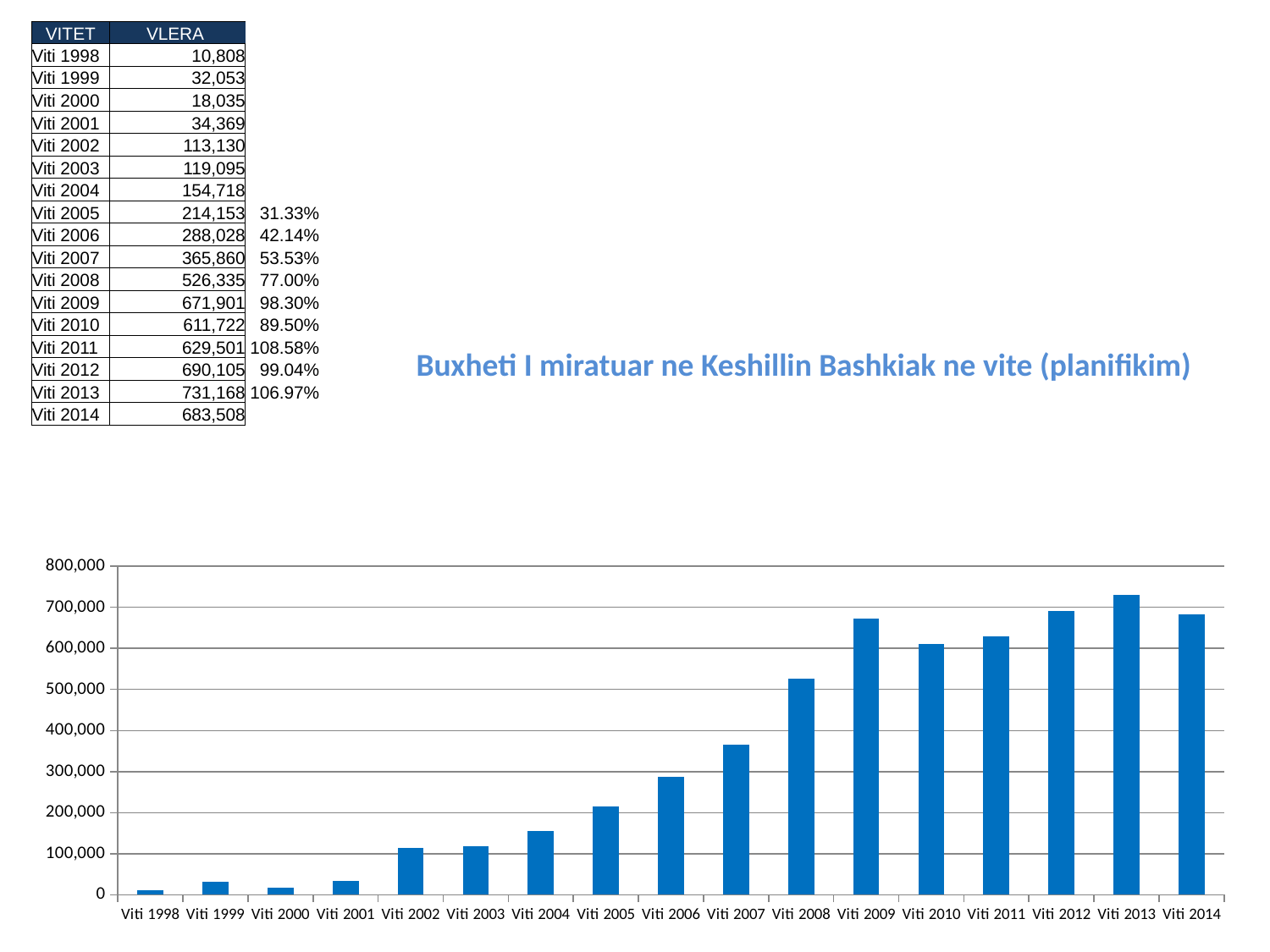
Is the value for Viti 2008 greater or less than 500,000? greater Is the value for Viti 2004 greater or less than 200,000? less How many years (bars) are plotted in the chart? 17 What kind of chart is shown on the slide? bar chart According to the table on the slide, what is the value for Viti 2013? 731,168 Which year has the lowest value in the chart? Viti 1998 Which is larger, the value for Viti 2012 or the value for Viti 2014? Viti 2012 What is the title of the chart? Buxheti I miratuar ne Keshillin Bashkiak ne vite (planifikim) Which year has the highest value in the chart? Viti 2013 According to the table on the slide, what is the value for Viti 2009? 671,901 Using the values in the table, what is the difference between Viti 2013 and Viti 2014? 47,660 Do the values generally rise or fall from Viti 1998 to Viti 2013? rise